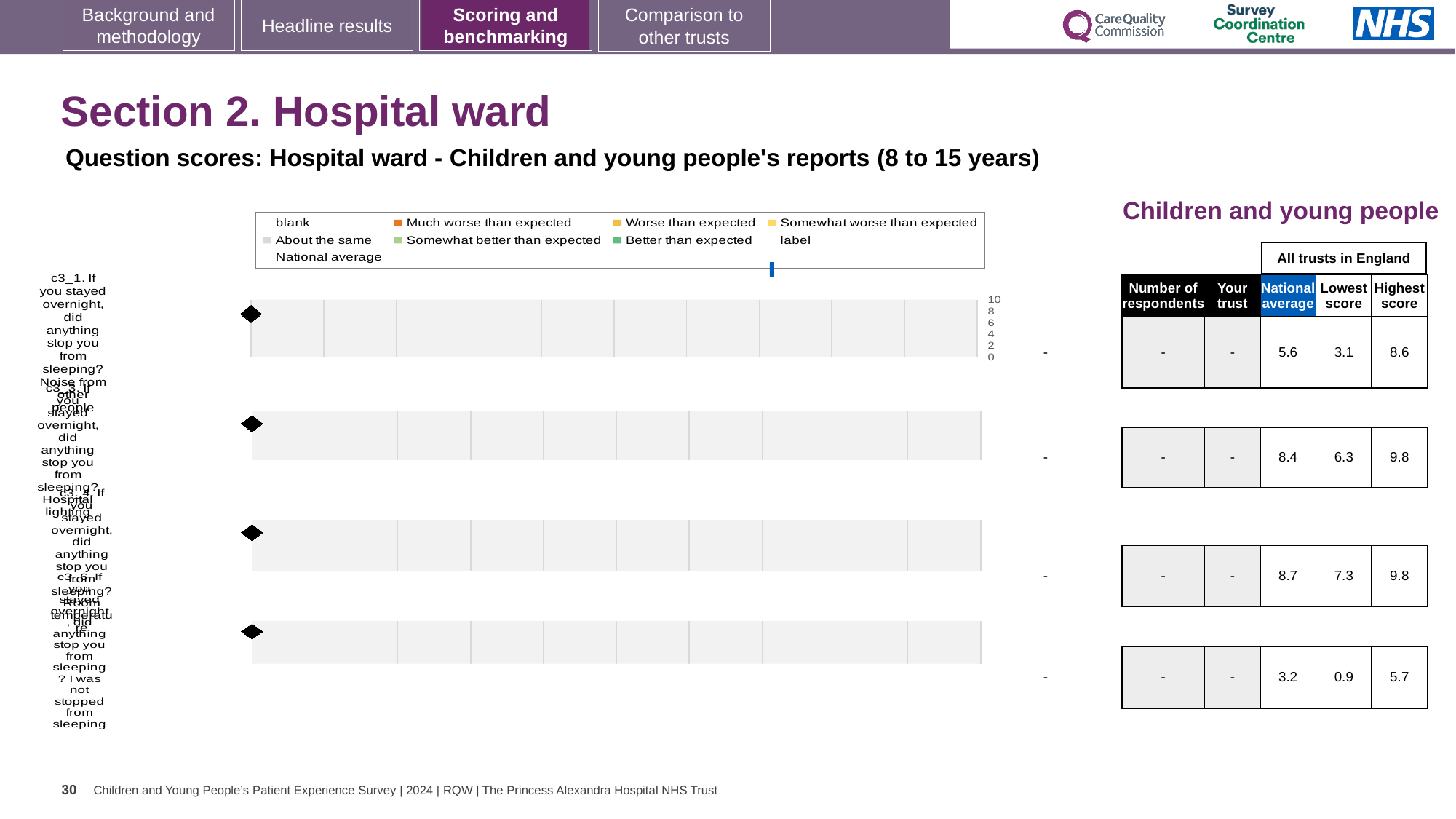
What is the highest value shown on the chart's numeric axis? 10 How many entries does the chart legend list? 9 What kind of chart is shown on the slide? bar chart In the table, what is the highest score for the second row (c3_3, hospital lighting)? 9.8 In the table, what is the national average for the first row (c3_1, noise from other people)? 5.6 In the table, what is the lowest score for the last row (c3_6, I was not stopped from sleeping)? 0.9 In the table, which row has the lowest national average? c3_6 (I was not stopped from sleeping), 3.2 In the table, what is the difference between the highest score and the lowest score for the first row (c3_1)? 5.5 How many question rows (bars) does the chart have? 4 Which legend entry is shown with an orange marker? Much worse than expected In the table, which row has the highest national average? c3_4 (room temperature), 8.7 In the table, is the national average for the third row (c3_4) larger or smaller than the national average for the second row (c3_3)? larger